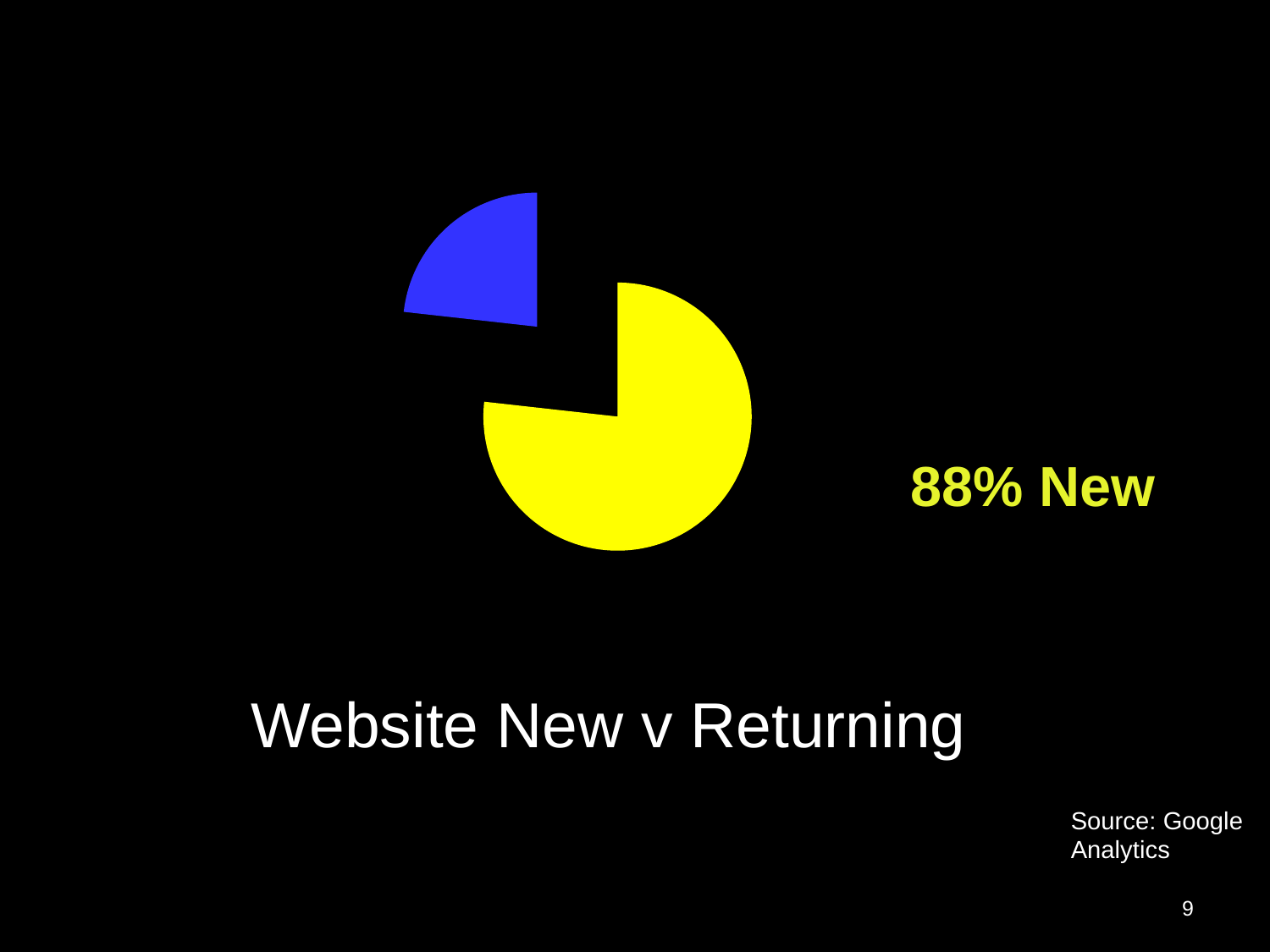
Which slice of the pie is the largest? New Is the share for Returning greater or less than 50%? less How many slices does the pie chart have? 2 Which slice of the pie is the smallest? Returning What is the source of the data cited on the slide? Google Analytics Is the share for New greater or less than 50%? greater Which is larger, the New slice or the Returning slice? New What share of the pie is labelled as New? 88% What is the title of the chart on the slide? Website New v Returning What kind of chart is shown on the slide? Pie chart